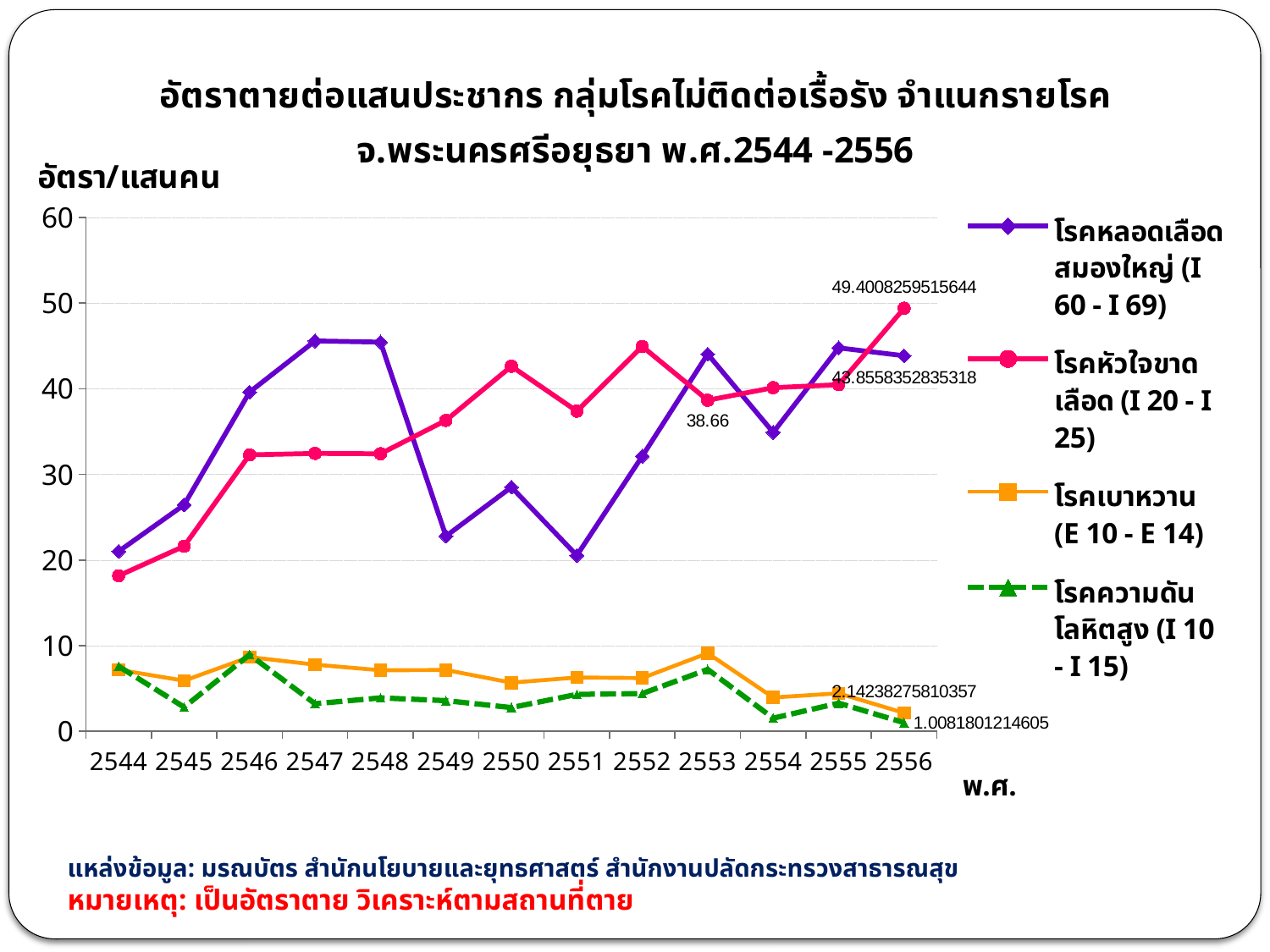
What is the value for โรคหลอดเลือดสมองใหญ่ (I 60 - I 69) in 2556? 43.8558352835318 In which year is the value for โรคหัวใจขาดเลือด (I 20 - I 25) highest? 2556 Which series has the highest value in 2556? โรคหัวใจขาดเลือด (I 20 - I 25) What is the value for โรคหัวใจขาดเลือด (I 20 - I 25) in 2553? 38.66 How many years are shown on the x axis? 13 Is the value for โรคหลอดเลือดสมองใหญ่ (I 60 - I 69) in 2547 greater or less than 40? greater What is the value for โรคเบาหวาน (E 10 - E 14) in 2556? 2.14238275810357 What is the difference between the 2556 values for โรคหัวใจขาดเลือด (I 20 - I 25) and โรคหลอดเลือดสมองใหญ่ (I 60 - I 69)? 5.5449906680326 What is the value for โรคความดันโลหิตสูง (I 10 - I 15) in 2556? 1.0081801214605 What kind of chart is shown on the slide? line chart How many series does the legend list? 4 What is the value for โรคหัวใจขาดเลือด (I 20 - I 25) in 2556? 49.4008259515644